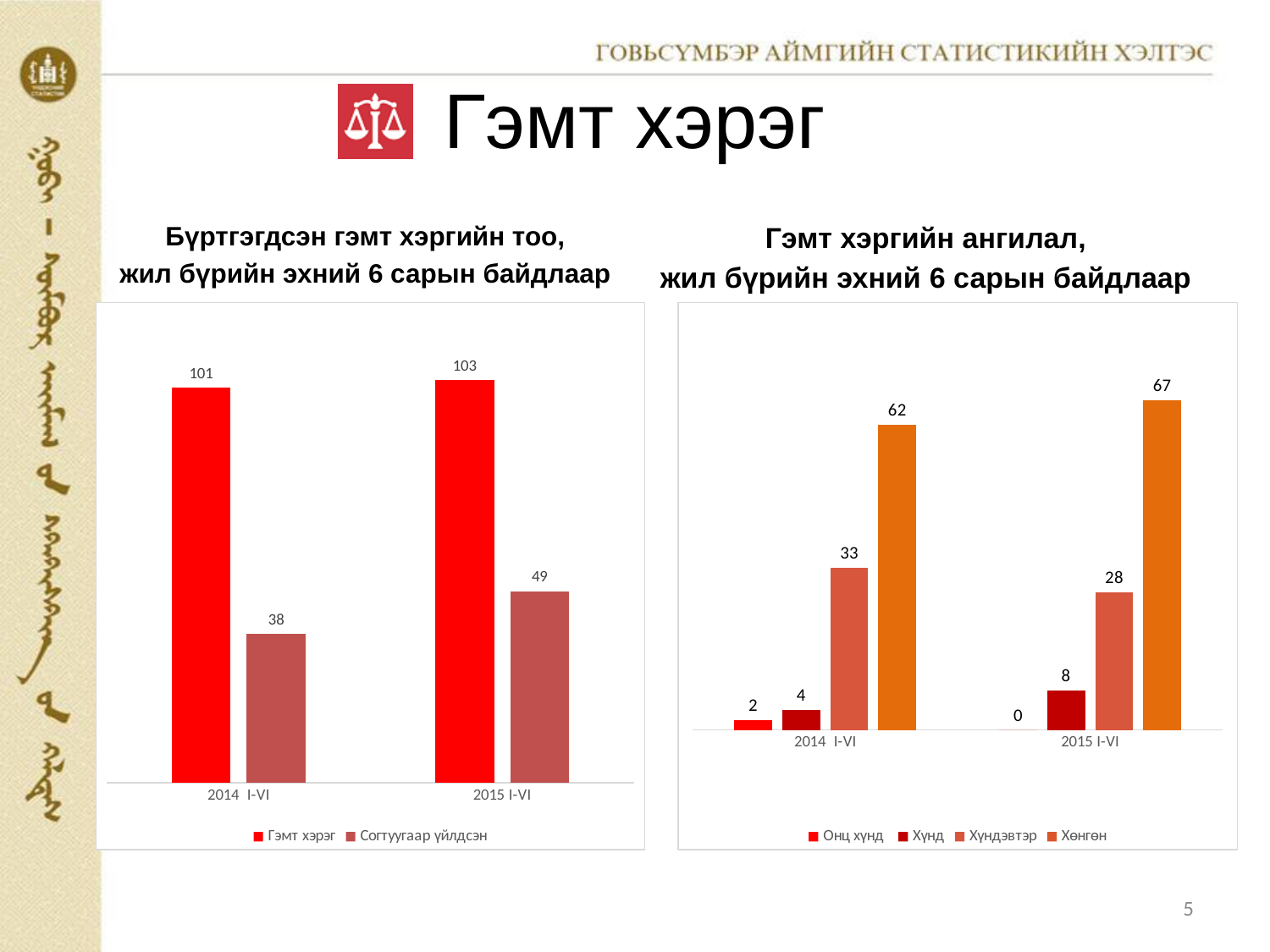
In the right chart (Гэмт хэргийн ангилал), how many series does the legend list? 4 In the left chart (Бүртгэгдсэн гэмт хэргийн тоо), did Согтуугаар үйлдсэн rise or fall from 2014 I-VI to 2015 I-VI? rise In the left chart (Бүртгэгдсэн гэмт хэргийн тоо), how many series does the legend list? 2 In the left chart (Бүртгэгдсэн гэмт хэргийн тоо), what is the difference between Гэмт хэрэг in 2015 I-VI and 2014 I-VI? 2 What type of chart is the right chart (Гэмт хэргийн ангилал)? bar chart In the left chart (Бүртгэгдсэн гэмт хэргийн тоо), what is the value of Гэмт хэрэг for 2014 I-VI? 101 In the right chart (Гэмт хэргийн ангилал), what is the difference between Хүндэвтэр in 2014 I-VI and 2015 I-VI? 5 In the right chart (Гэмт хэргийн ангилал), what is the value of Хүнд for 2014 I-VI? 4 In the left chart (Бүртгэгдсэн гэмт хэргийн тоо), what is the value of Согтуугаар үйлдсэн for 2015 I-VI? 49 In the right chart (Гэмт хэргийн ангилал), which category has the highest value in 2014 I-VI? Хөнгөн In the right chart (Гэмт хэргийн ангилал), what is the value of Хөнгөн for 2015 I-VI? 67 In the right chart (Гэмт хэргийн ангилал), which category has the lowest value in 2015 I-VI? Онц хүнд